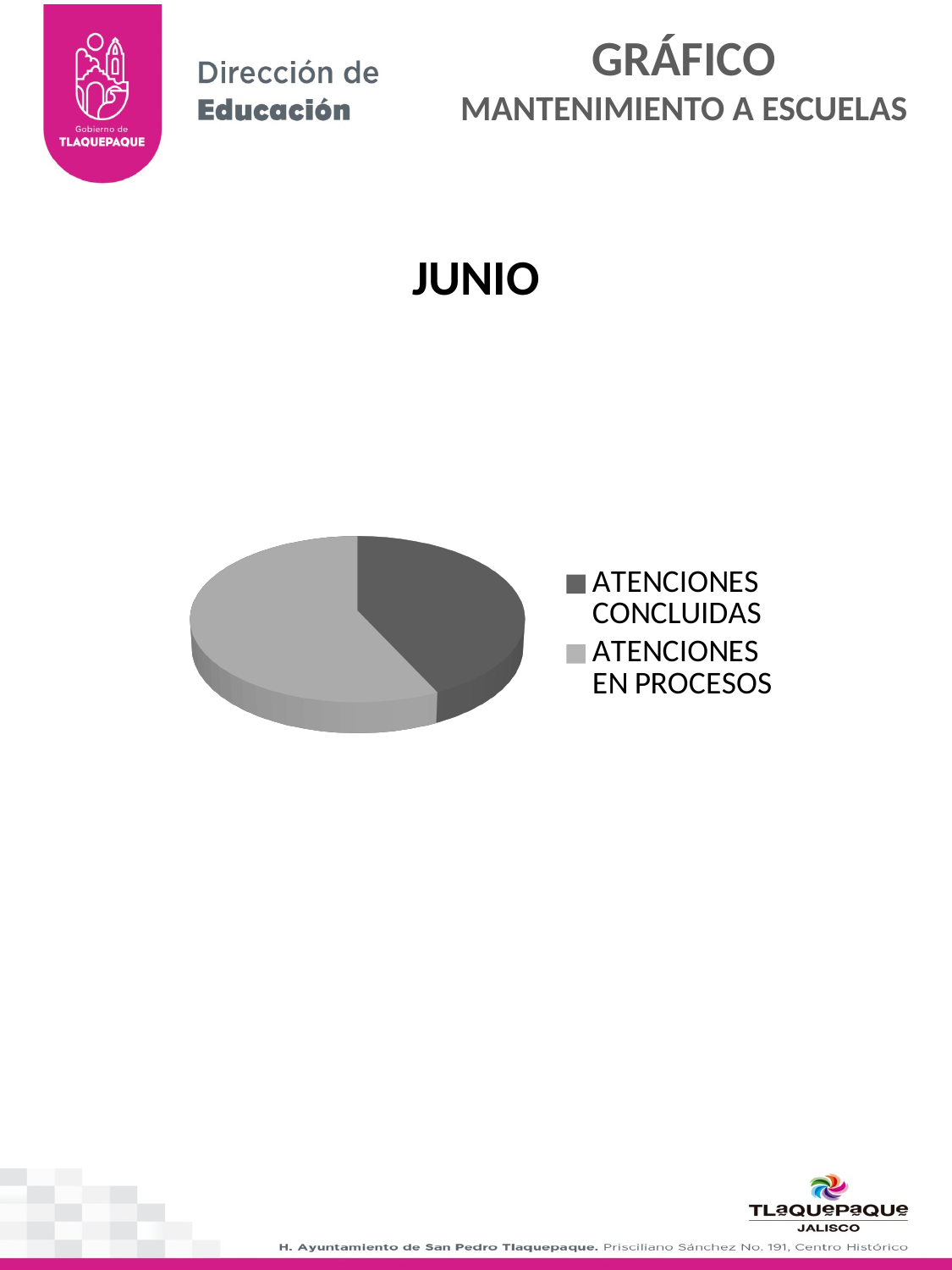
What kind of chart is shown on the slide? Pie chart Which category has the smallest slice in the pie chart? ATENCIONES CONCLUIDAS How many entries does the legend of the pie chart list? 2 What is the title shown above the pie chart? JUNIO Which slice is larger, ATENCIONES CONCLUIDAS or ATENCIONES EN PROCESOS? ATENCIONES EN PROCESOS How many slices does the pie chart have? 2 Which colour represents ATENCIONES CONCLUIDAS in the pie chart? Dark gray Which category has the largest slice in the pie chart? ATENCIONES EN PROCESOS